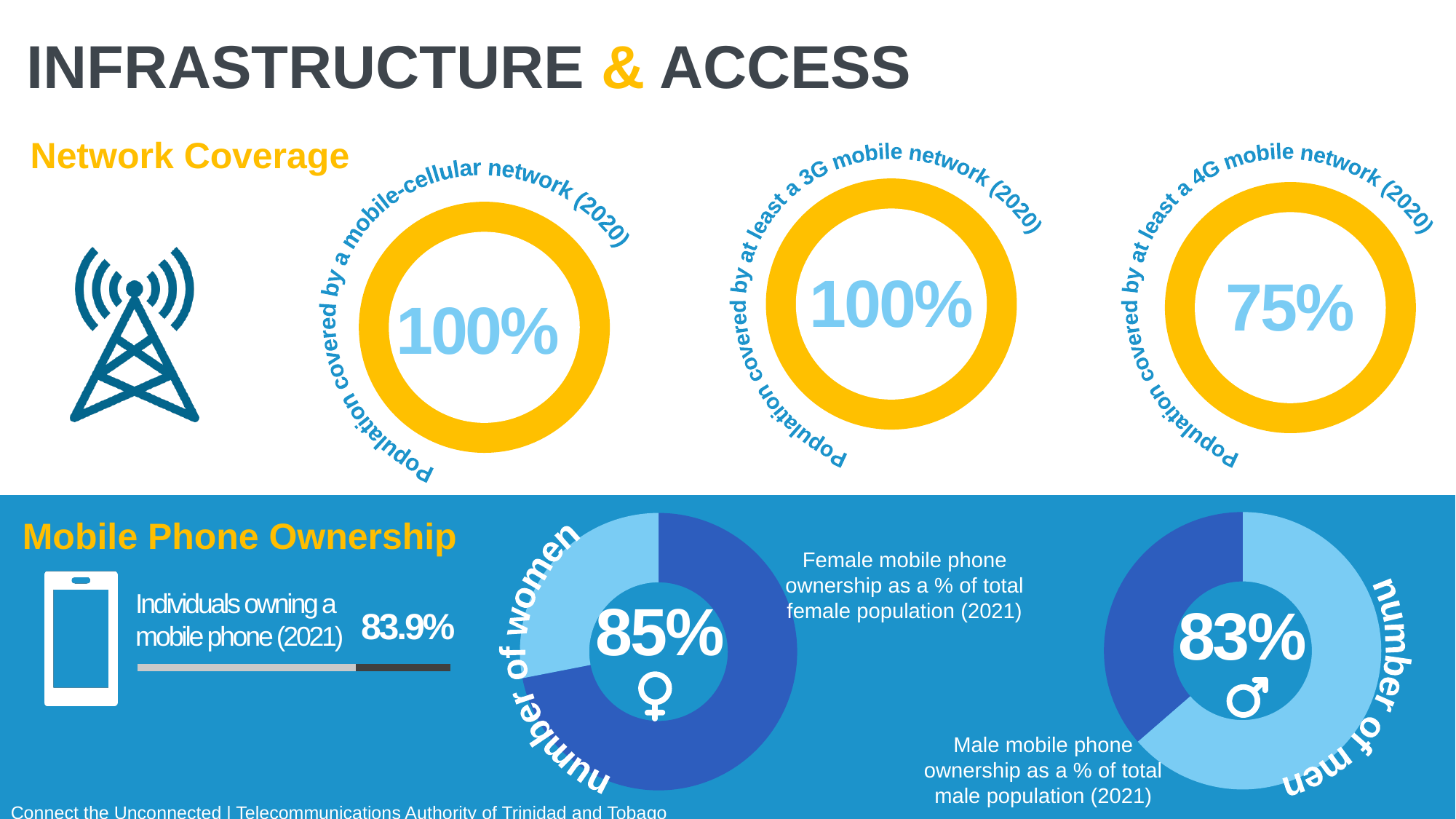
What percentage of individuals owned a mobile phone in 2021? 83.9% What percentage of the population is covered by a mobile-cellular network (2020)? 100% What is the difference between female and male mobile phone ownership percentages (2021)? 2% In the Network Coverage section, which network type has the lowest population coverage? 4G mobile network What is the difference between the 3G mobile network coverage and the 4G mobile network coverage? 25% In the Mobile Phone Ownership section, what is female mobile phone ownership as a % of total female population (2021)? 85% What percentage of the population is covered by at least a 3G mobile network (2020)? 100% What percentage of the population is covered by at least a 4G mobile network (2020)? 75% Which is higher, female mobile phone ownership or male mobile phone ownership (2021)? Female mobile phone ownership What kind of chart is used to show the female and male mobile phone ownership figures? Donut chart In the Mobile Phone Ownership section, what is male mobile phone ownership as a % of total male population (2021)? 83% How many network coverage ring charts are shown in the Network Coverage section? 3